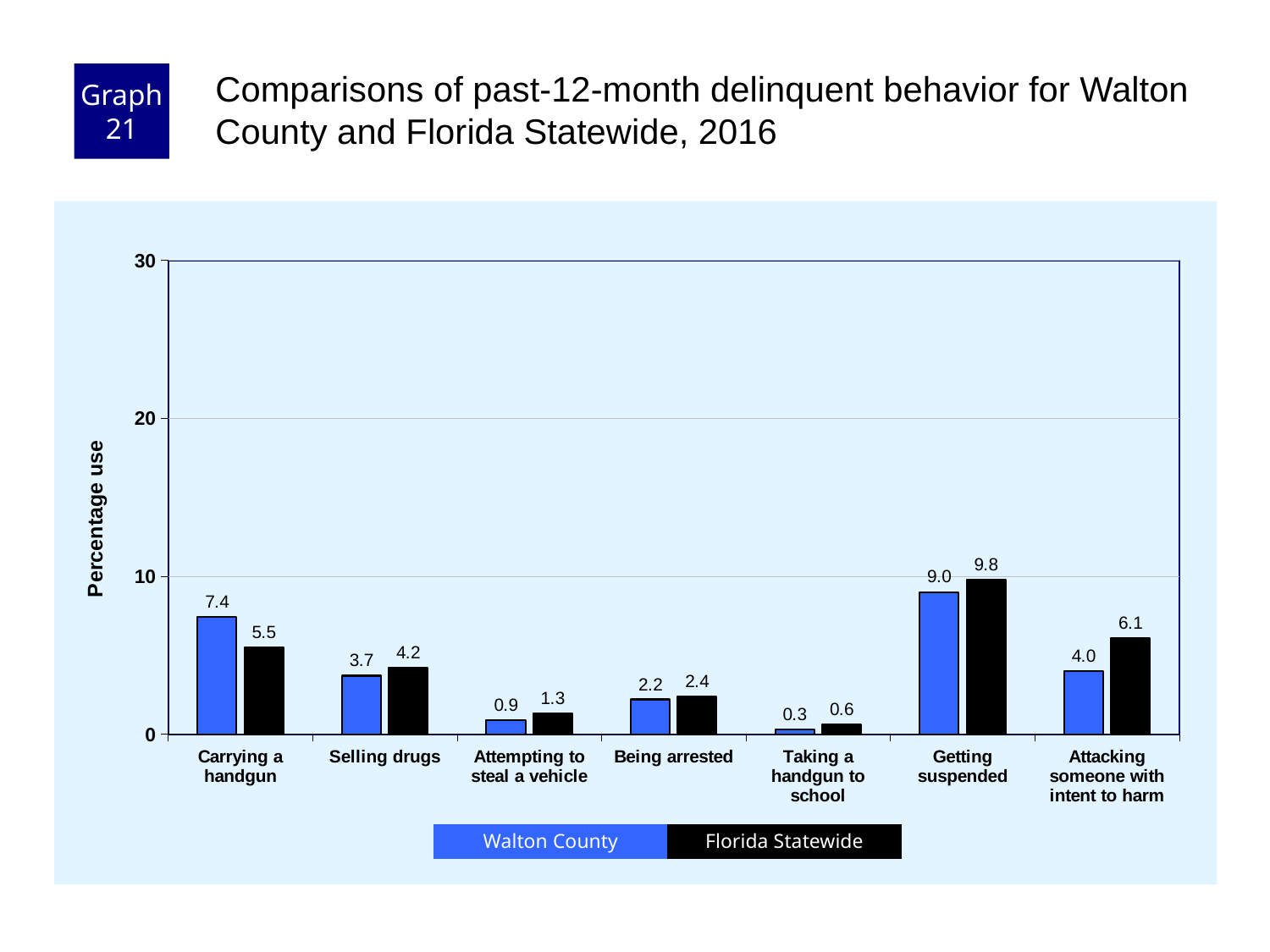
For Carrying a handgun, which is larger: the Walton County value or the Florida Statewide value? Walton County What is the difference between the Florida Statewide and Walton County values for Attacking someone with intent to harm? 2.1 Is the Florida Statewide value for Getting suspended greater or less than 10? less What is the Florida Statewide value for Getting suspended? 9.8 How many series does the legend list? 2 What kind of chart is shown on the slide? bar chart Which category has the lowest Florida Statewide value? Taking a handgun to school What is the Walton County value for Taking a handgun to school? 0.3 What is the label of the y axis? Percentage use How many categories are shown on the x axis? 7 Which category has the highest Walton County value? Getting suspended What is the Walton County value for Carrying a handgun? 7.4